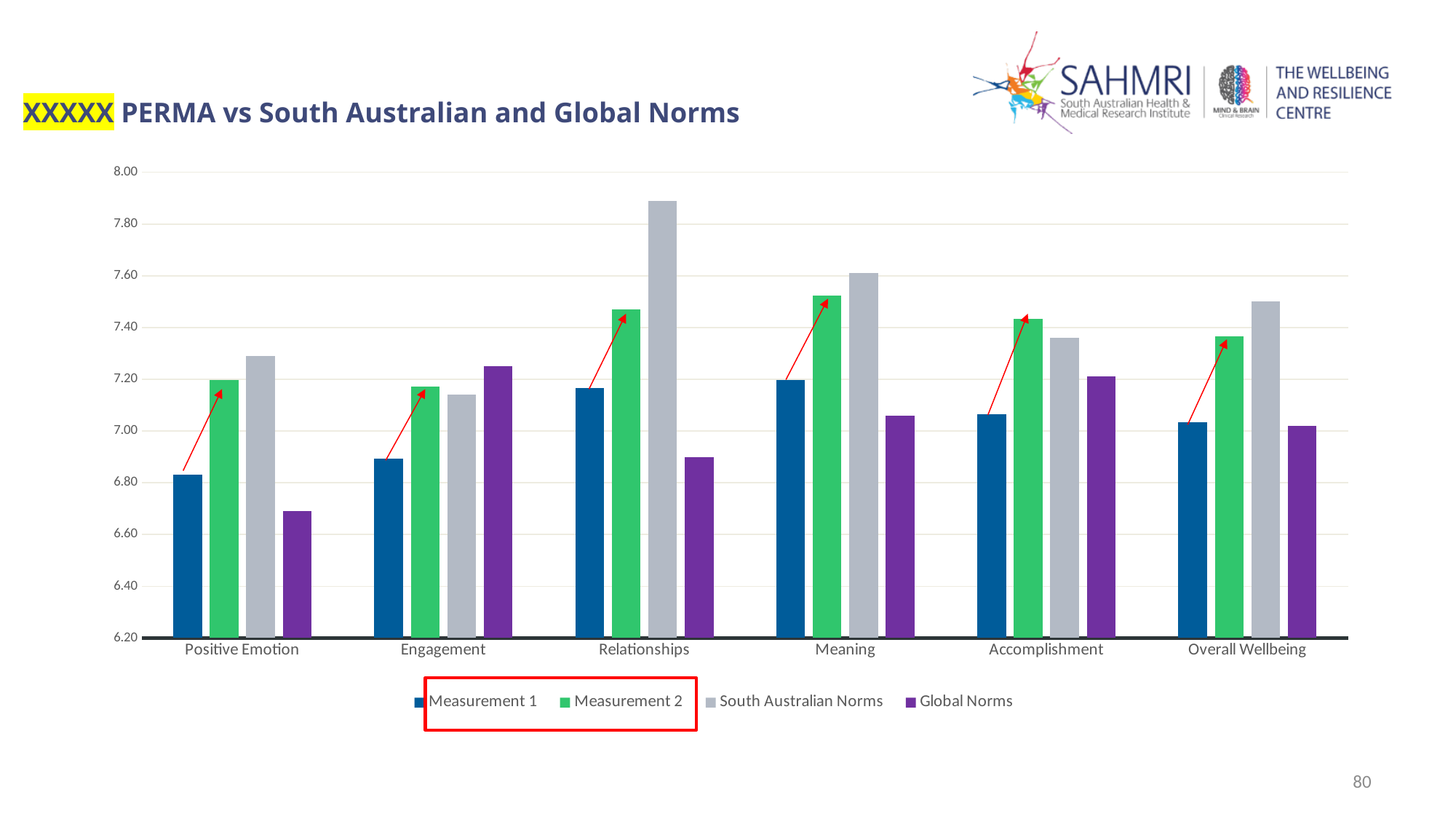
Is the Measurement 2 value for Meaning greater or less than 7.40? greater How many series does the legend list? 4 Is the South Australian Norms value for Relationships greater or less than 7.80? greater For Engagement, which is larger: South Australian Norms or Global Norms? Global Norms For Meaning, which is larger: Measurement 1 or Measurement 2? Measurement 2 Is the Measurement 1 value for Positive Emotion greater or less than 7.00? less What kind of chart is shown on the slide? Bar chart Which category has the lowest Global Norms bar? Positive Emotion Which two legend entries are outlined by the red box? Measurement 1 and Measurement 2 How many categories are shown along the x axis? 6 Which category has the highest South Australian Norms bar? Relationships